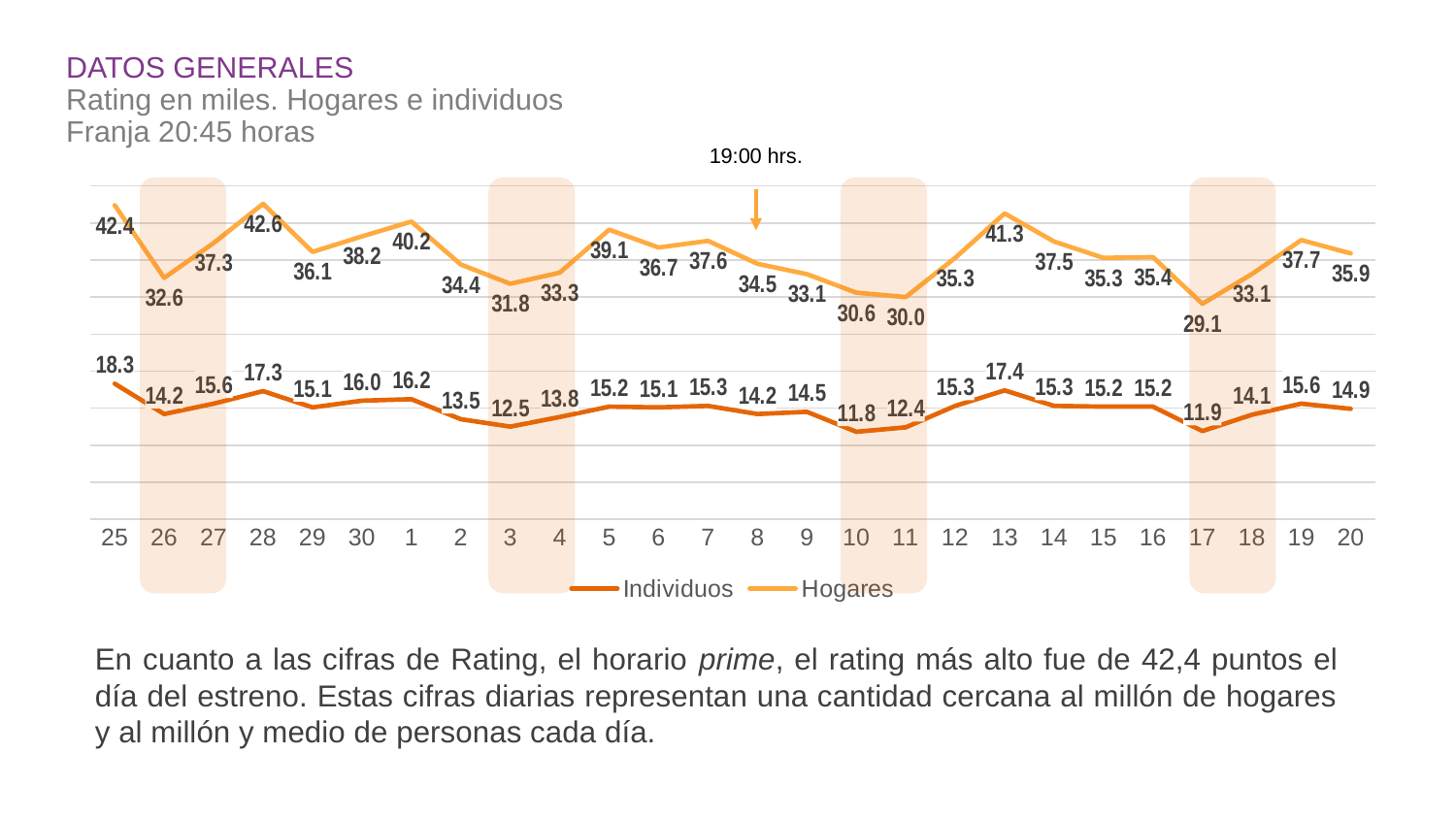
How many days are plotted on the x axis? 26 What is the Hogares value on day 17? 29.1 On which day is the Individuos value lowest? 10 On which day is the Individuos value highest? 25 On which day is the Hogares value lowest? 17 Which is larger, the Hogares value on day 1 or on day 5? day 1 What is the Hogares value on day 28? 42.6 How many series does the legend list? 2 What type of chart is shown on the slide? line chart What is the Individuos value on day 13? 17.4 What is the difference between the Hogares value on day 25 and on day 26? 9.8 What time is marked by the arrow annotation above the chart? 19:00 hrs.